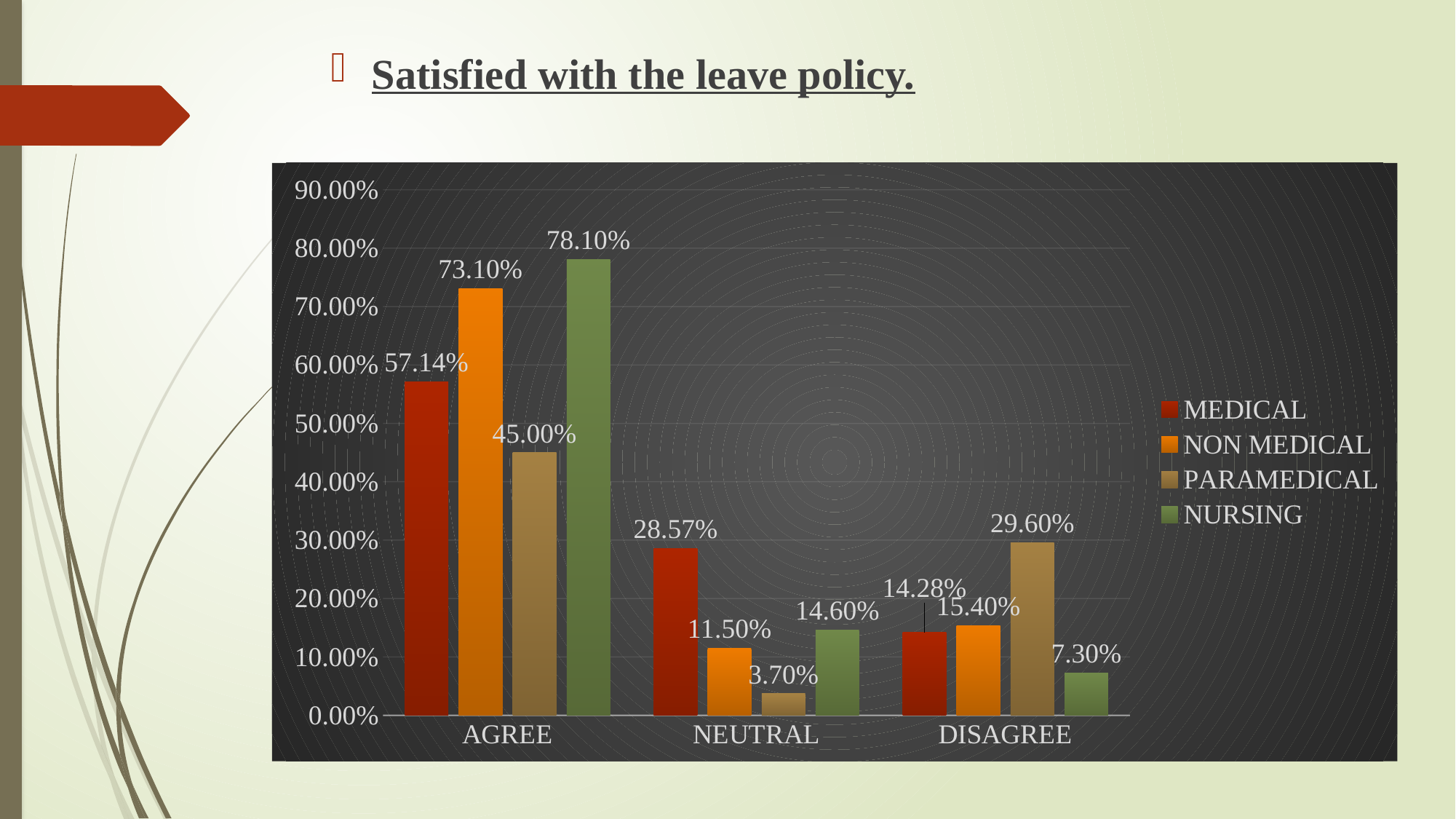
What is the value for PARAMEDICAL in the DISAGREE category? 29.60% Which series has the highest value in the AGREE category? NURSING How many categories are shown on the x axis? 3 What kind of chart is shown on the slide? Bar chart What is the title of the slide above the chart? Satisfied with the leave policy. Which series has the lowest value in the NEUTRAL category? PARAMEDICAL What is the difference between the NURSING and MEDICAL values in the AGREE category? 20.96% What is the value for NURSING in the AGREE category? 78.10% Which is larger: the PARAMEDICAL value for DISAGREE or the NON MEDICAL value for DISAGREE? PARAMEDICAL What is the value for NON MEDICAL in the AGREE category? 73.10% How many series does the legend list? 4 What is the value for MEDICAL in the NEUTRAL category? 28.57%